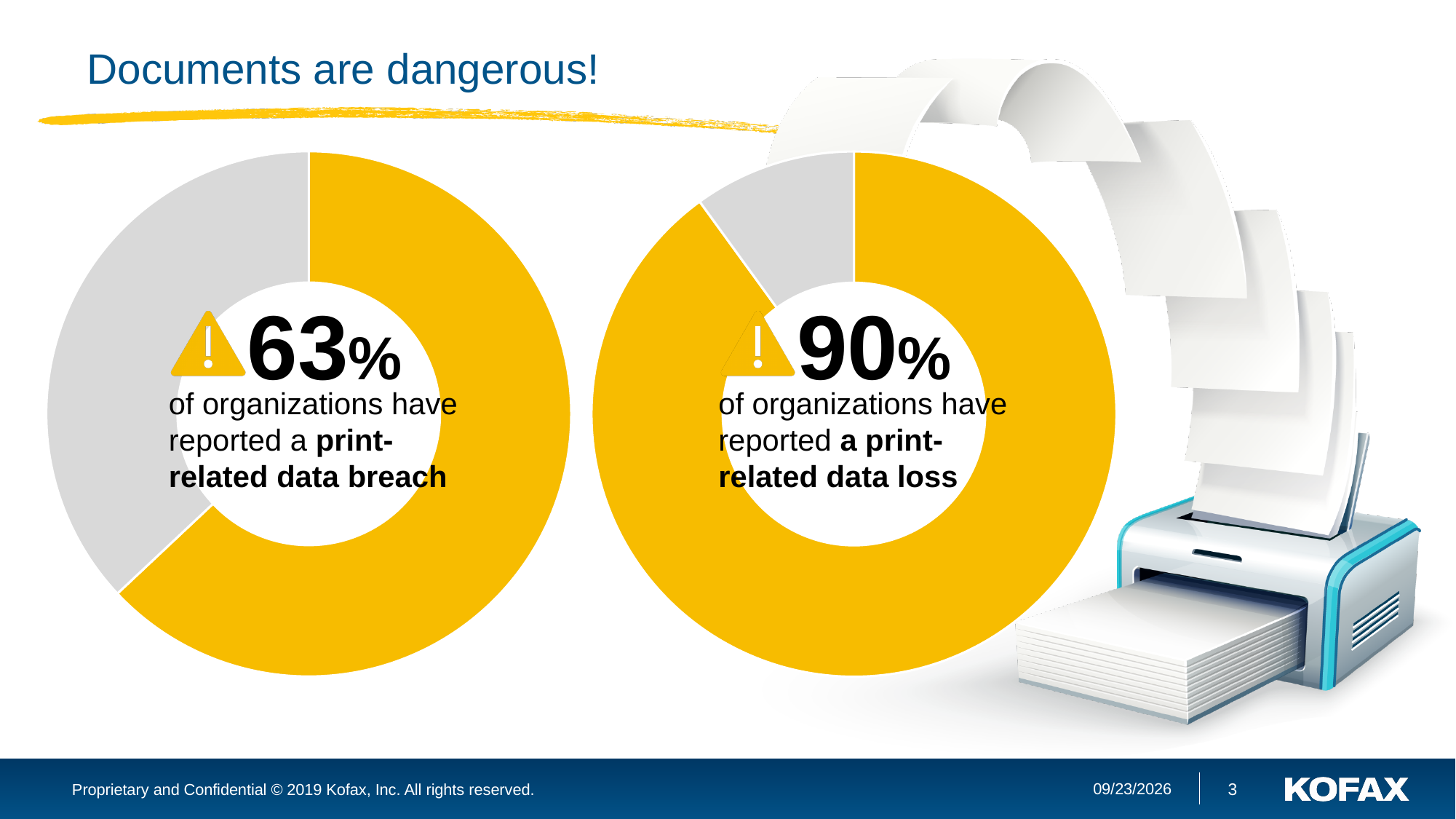
How many segments does each donut chart have? 2 What is the title of the slide containing the two donut charts? Documents are dangerous! What kind of chart is used on the left of the slide? Donut chart Which is larger: the percentage in the left donut chart (print-related data breach) or the percentage in the right donut chart (print-related data loss)? Print-related data loss (90%) In the left donut chart, is the highlighted yellow share greater or less than 50%? greater In the right donut chart, what percentage of organizations have reported a print-related data loss? 90% What is the difference between the percentage shown in the right donut chart and the percentage shown in the left donut chart? 27% How many donut charts are shown on the slide? 2 In the left donut chart, what percentage of organizations have reported a print-related data breach? 63% What colour is used for the highlighted share in both donut charts? Yellow In the right donut chart, is the grey (remaining) share greater or less than 25%? less What kind of chart is used on the right of the slide? Donut chart